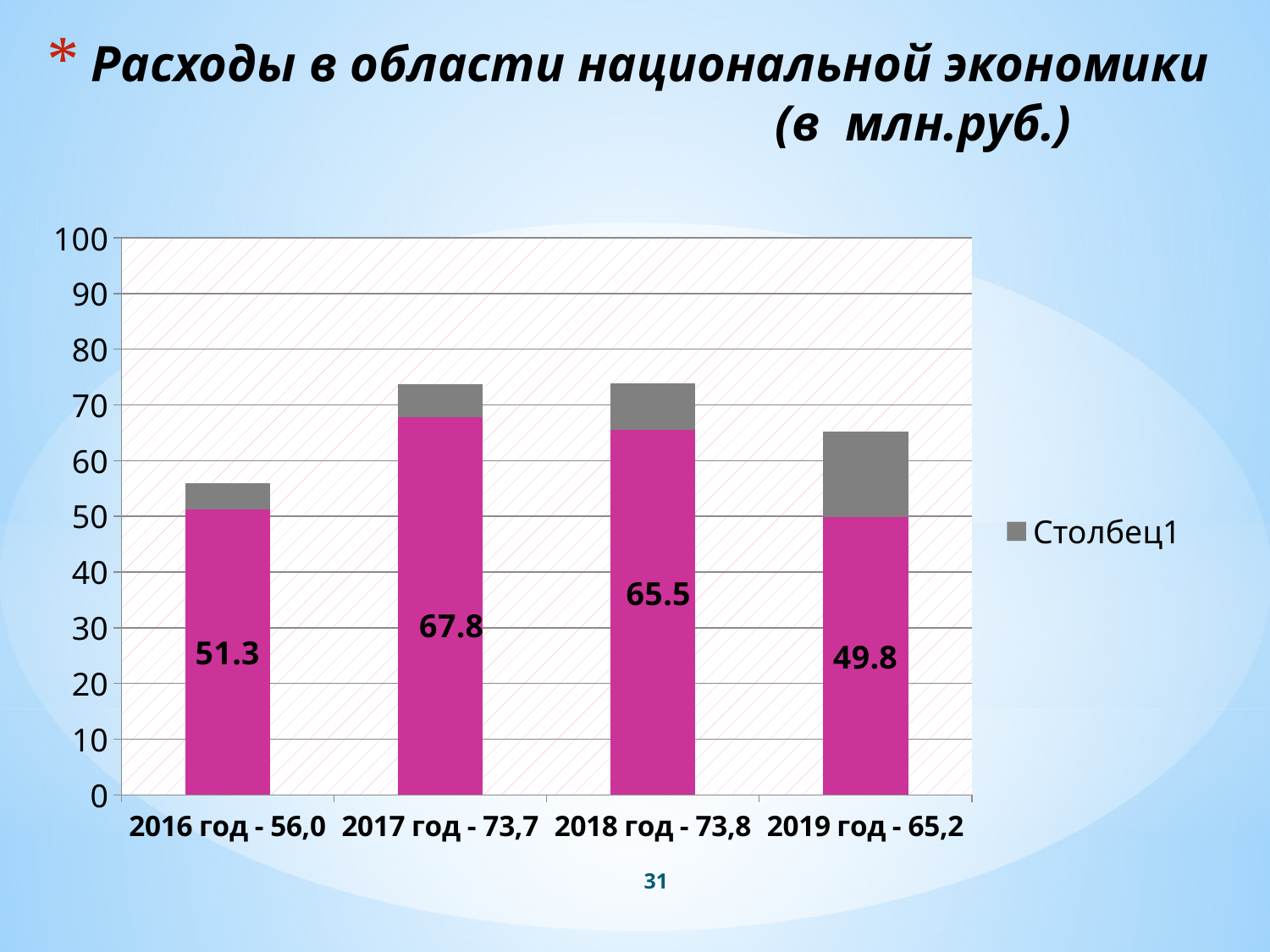
What is the magenta (labelled) value for 2016? 51.3 Which year has the lowest labelled magenta value? 2019 Is the total height of the 2019 bar greater or less than 60? greater Which year has the highest labelled magenta value? 2017 Which is larger, the labelled magenta value for 2016 or for 2019? 2016 What is the magenta (labelled) value for 2019? 49.8 How many years (categories) are shown on the x axis? 4 What is the magenta (labelled) value for 2017? 67.8 What is the total of the stacked bar for 2016, as given in its category label? 56,0 What type of chart is shown on the slide? Stacked bar chart How many series does the legend list? 1 What is the difference between the labelled magenta values for 2017 and 2018? 2.3